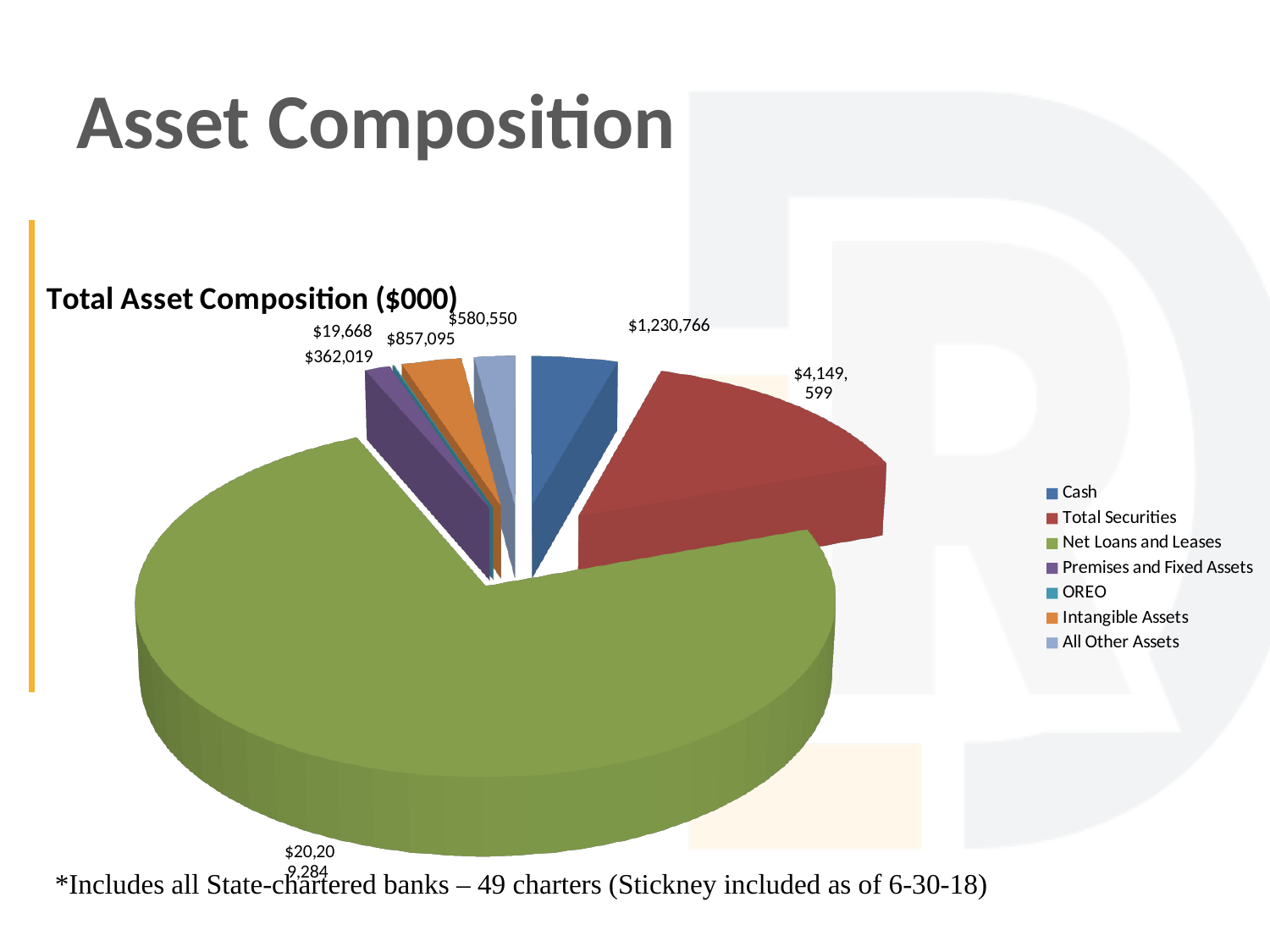
Which category has the largest slice of the pie? Net Loans and Leases Which is larger, Cash or Total Securities? Total Securities What kind of chart is shown on the slide? Pie chart What is the title of the chart? Total Asset Composition ($000) What is the value shown for Cash? $1,230,766 What is the value shown for OREO? $19,668 What is the value shown for All Other Assets? $580,550 What is the value shown for Premises and Fixed Assets? $362,019 What is the value shown for Total Securities? $4,149,599 How many categories does the legend of the pie chart list? 7 What is the value shown for Intangible Assets? $857,095 Which category has the smallest slice of the pie? OREO